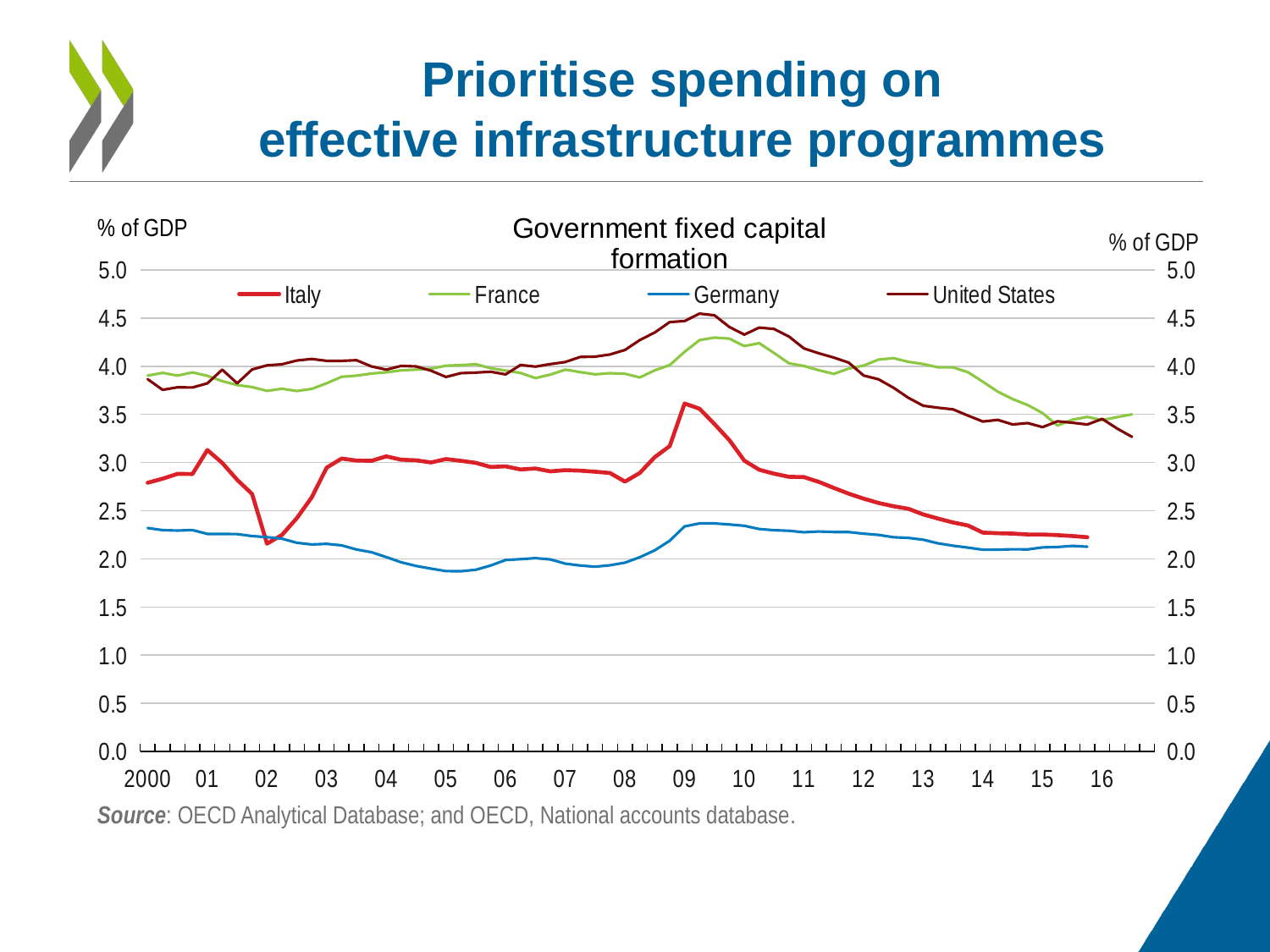
How many series does the legend list? 4 Is the value for Germany in 2005 greater or less than 2.0? less Is the value for the United States in 2009 greater or less than 4.0? greater In 2010, which is larger, the value for France or the value for Germany? France What is the title of the chart? Government fixed capital formation Which series has the lowest value in 2005? Germany Is the value for Italy in 2009 greater or less than 3.5? greater What kind of chart is shown on the slide? line chart Which series has the highest value in 2013? France Does the value for Italy rise or fall from 2009 to 2016? fall What unit is shown on the vertical axis of the chart? % of GDP